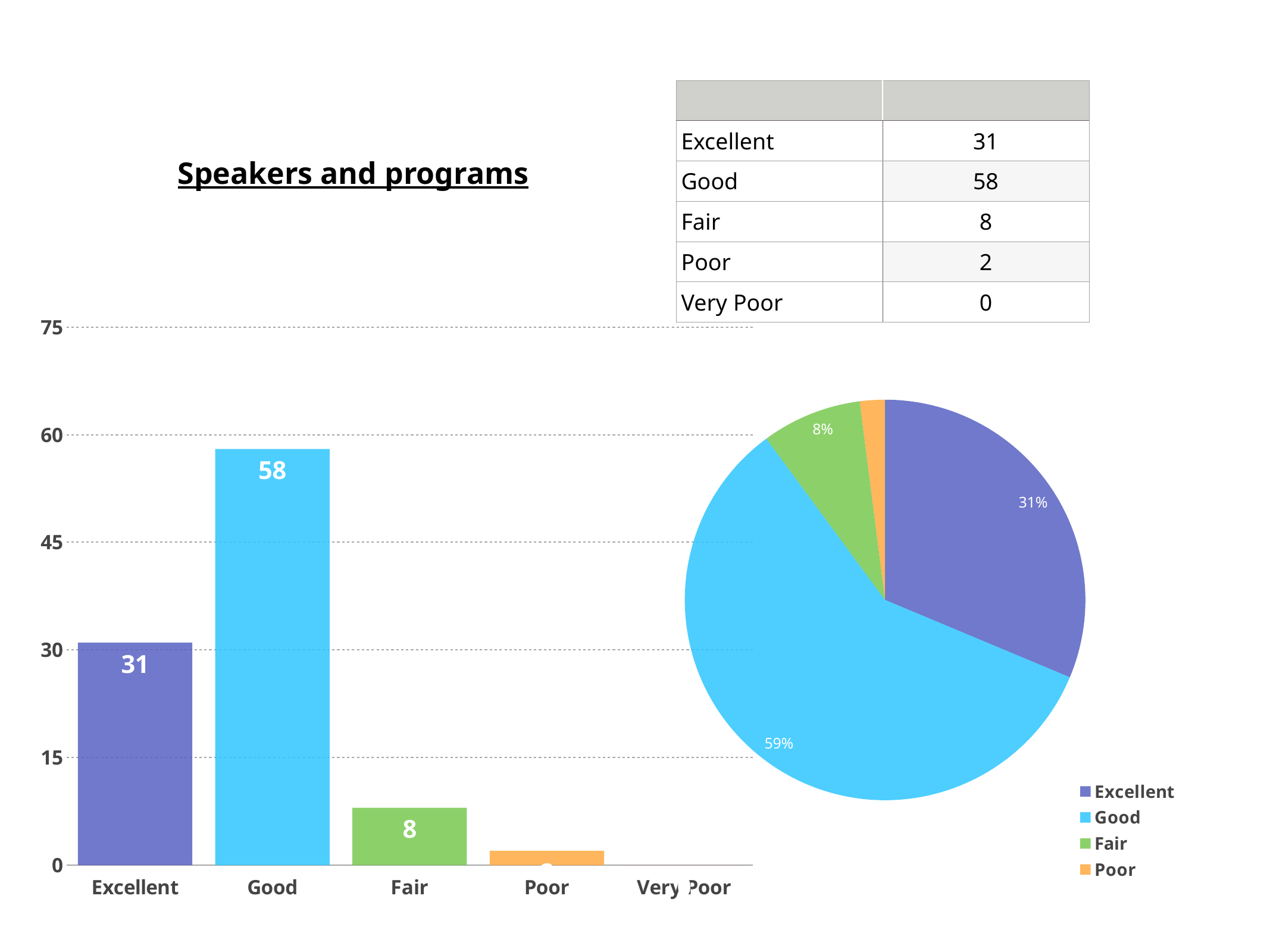
How many entries does the legend of the pie chart list? 4 On the bar chart, what is the difference between the values for Good and Excellent? 27 On the bar chart, which is larger, the value for Excellent or the value for Fair? Excellent On the bar chart, what is the value for Good? 58 On the bar chart, what is the value for Excellent? 31 On the bar chart, is the value for Poor greater or less than 15? less What kind of chart is the chart on the left of the slide? bar chart How many categories are shown on the x axis of the bar chart? 5 On the bar chart, what is the value for Fair? 8 On the bar chart, which category has the highest value? Good On the pie chart, what share does the Good slice have? 59% On the pie chart, what share does the Fair slice have? 8%